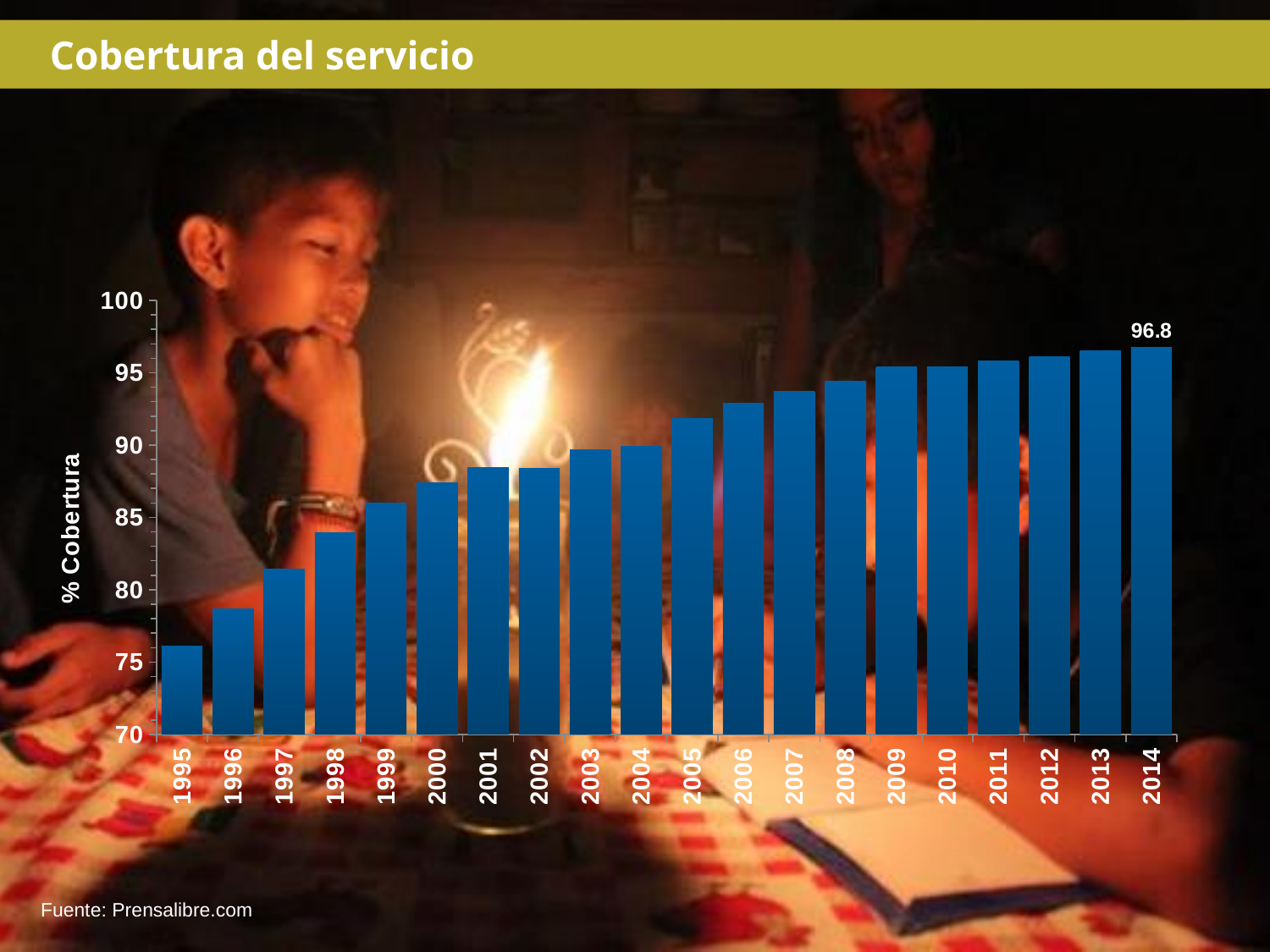
Is the value for 2013 greater or less than 95? greater What is the label on the y axis? % Cobertura How many years are shown on the x axis? 20 Do the values rise or fall from 1995 to 2014? Rise Is the value for 1995 greater or less than 80? less Which year has the highest coverage value? 2014 Which year has the lowest coverage value? 1995 What kind of chart is shown on the slide? Bar chart Which is larger, the value for 2008 or the value for 2006? 2008 Is the value for 2000 greater or less than 85? greater What is the value shown for 2014? 96.8